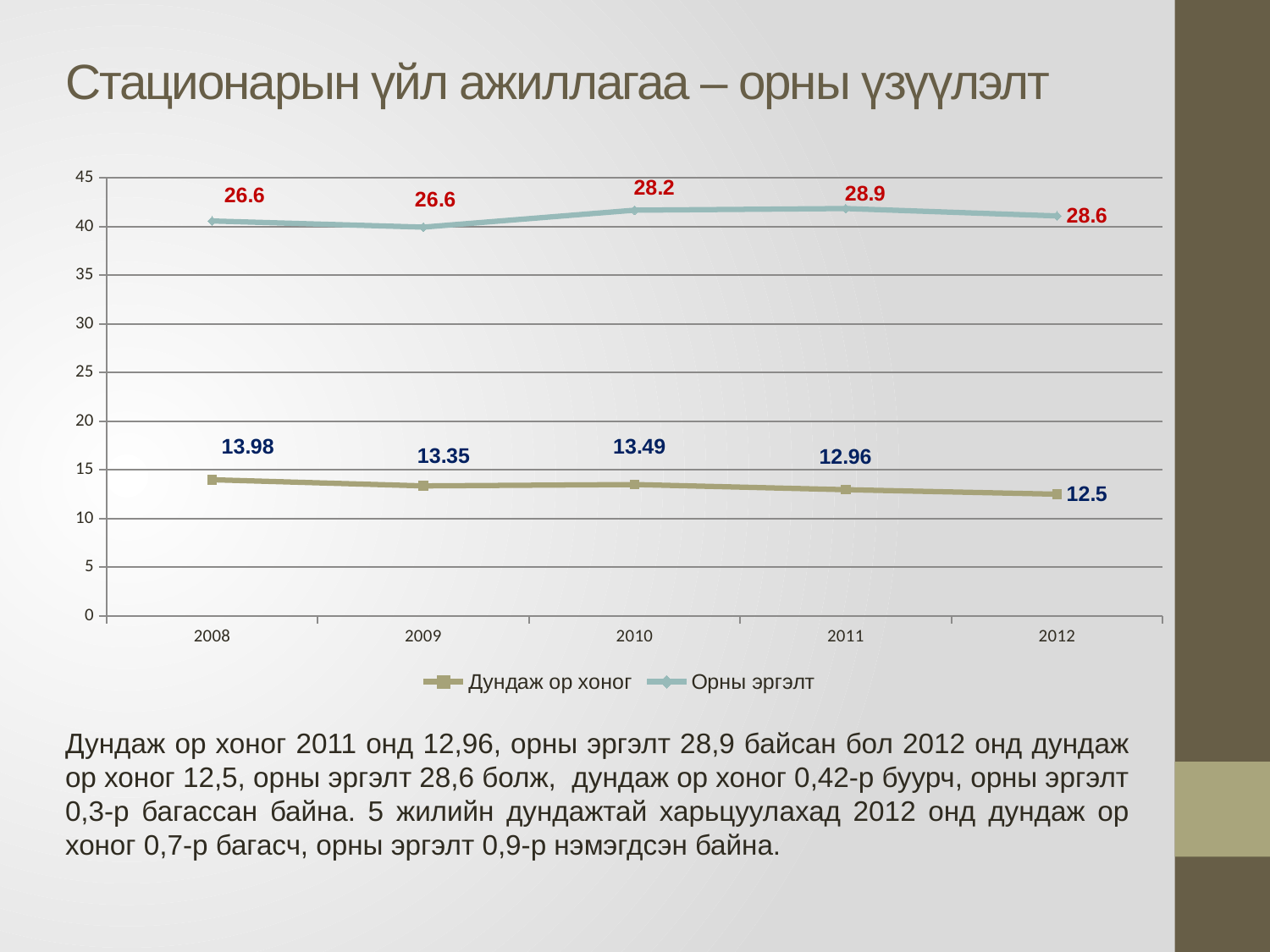
What is the value of Орны эргэлт in 2011? 28.9 In which year is Дундаж ор хоног highest? 2008 What kind of chart is shown on the slide? Line chart What is the value of Дундаж ор хоног in 2008? 13.98 In which year is Орны эргэлт highest? 2011 In which year is Дундаж ор хоног lowest? 2012 Which year has the larger Дундаж ор хоног value, 2009 or 2010? 2010 How many series does the legend list? 2 By how much did Орны эргэлт decrease from 2011 to 2012? 0.3 What is the value of Орны эргэлт in 2009? 26.6 Does Дундаж ор хоног generally rise or fall from 2008 to 2012? Fall How many years are shown on the x axis? 5